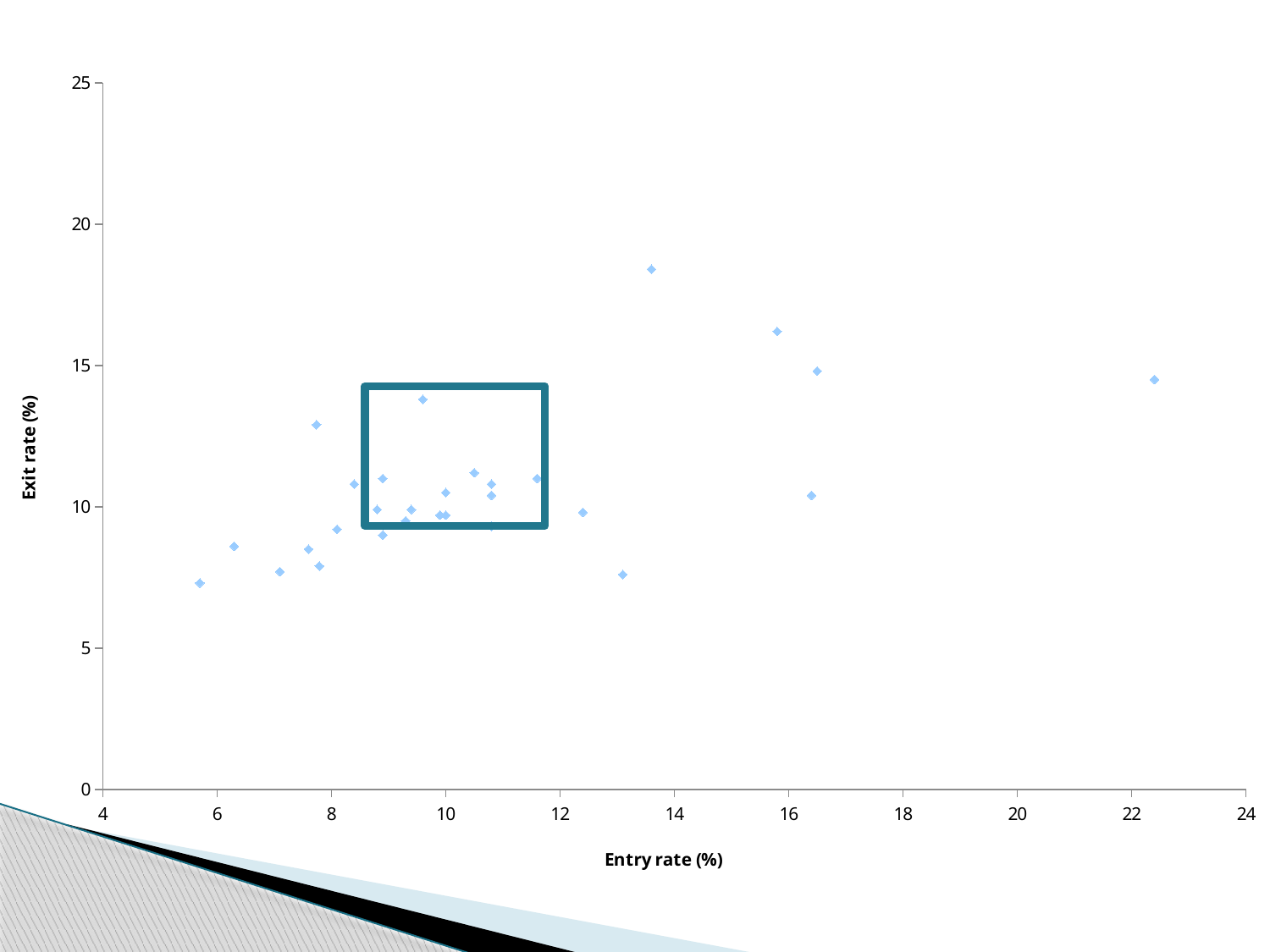
Is the exit rate of the point with the highest exit rate greater or less than 15? greater Is the highest entry rate plotted on the chart greater or less than 20? greater Is the exit rate of the point with the highest entry rate greater or less than 10? greater What is the label of the vertical axis? Exit rate (%) What is the label of the horizontal axis? Entry rate (%) What kind of chart is shown on the slide? scatter chart